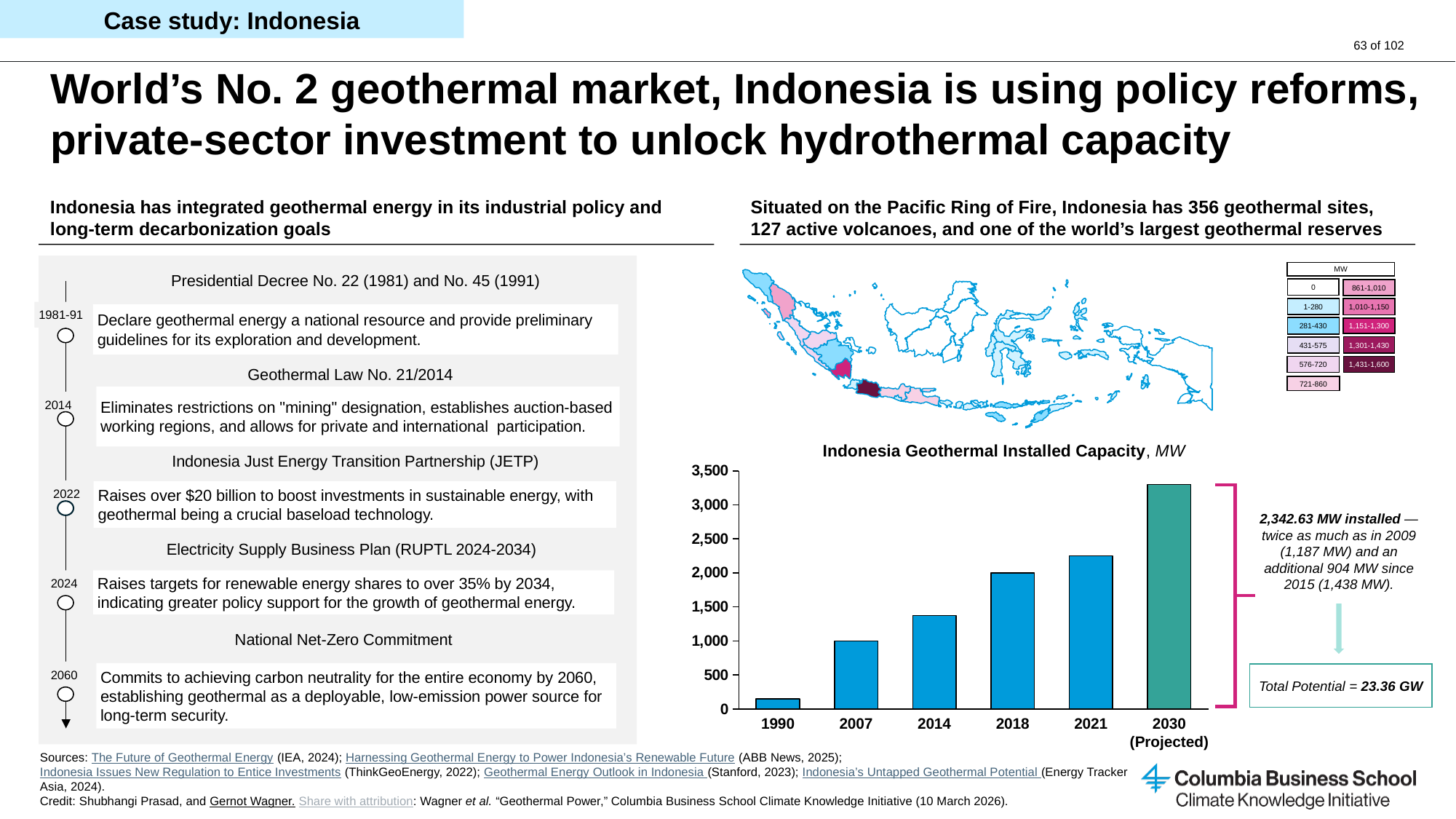
In the 'Indonesia Geothermal Installed Capacity' chart, is the value for 1990 greater or less than 500? less In the 'Indonesia Geothermal Installed Capacity' chart, which year has the lowest bar? 1990 How many years are shown on the x axis of the 'Indonesia Geothermal Installed Capacity' chart? 6 In the 'Indonesia Geothermal Installed Capacity' chart, which year has the highest bar? 2030 (Projected) In the 'Indonesia Geothermal Installed Capacity' chart, is the value for 2030 (Projected) greater or less than 3,000? greater In the 'Indonesia Geothermal Installed Capacity' chart, is the value for 2021 greater or less than 2,000? greater In the 'Indonesia Geothermal Installed Capacity' chart, do the values rise or fall from 1990 to 2030? rise What is the highest tick value on the y axis of the 'Indonesia Geothermal Installed Capacity' chart? 3,500 In the 'Indonesia Geothermal Installed Capacity' chart, which is larger, the value for 2014 or the value for 2021? 2021 What unit is given in the title of the 'Indonesia Geothermal Installed Capacity' chart? MW What kind of chart is 'Indonesia Geothermal Installed Capacity, MW'? bar chart